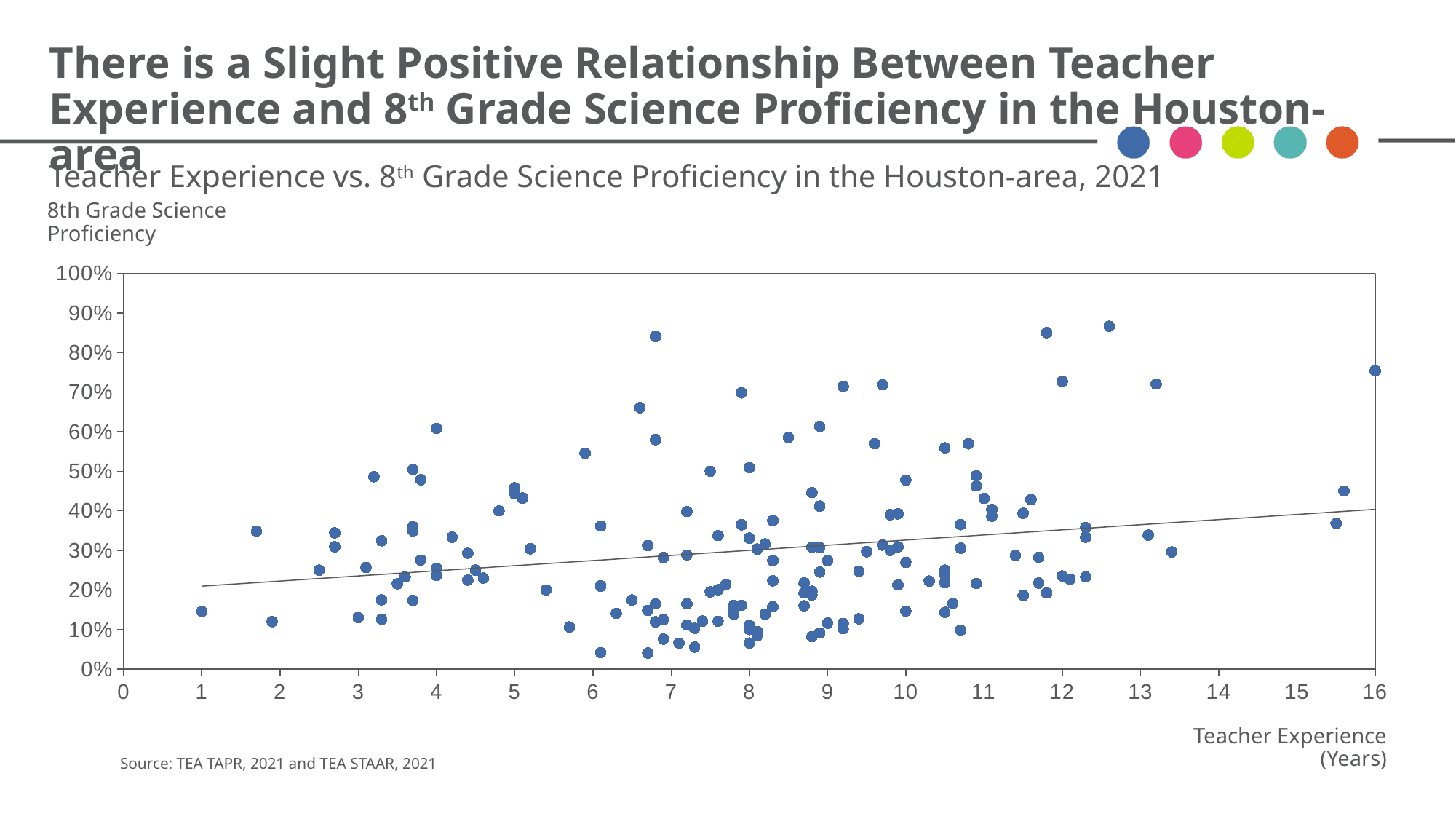
Is the proficiency value for the point at 16 years of teacher experience greater or less than 70%? greater What is the maximum value shown on the y axis? 100% What is the label of the x axis? Teacher Experience (Years) Is the proficiency value for the point at about 15.5 years of teacher experience greater or less than 50%? less According to the trend line, do 8th grade science proficiency values rise or fall as teacher experience increases? Rise What kind of chart is shown on the slide? Scatter plot What is the title of the chart? Teacher Experience vs. 8th Grade Science Proficiency in the Houston-area, 2021 What is the maximum value shown on the x axis? 16 Is the proficiency value for the point at 1 year of teacher experience greater or less than 20%? less